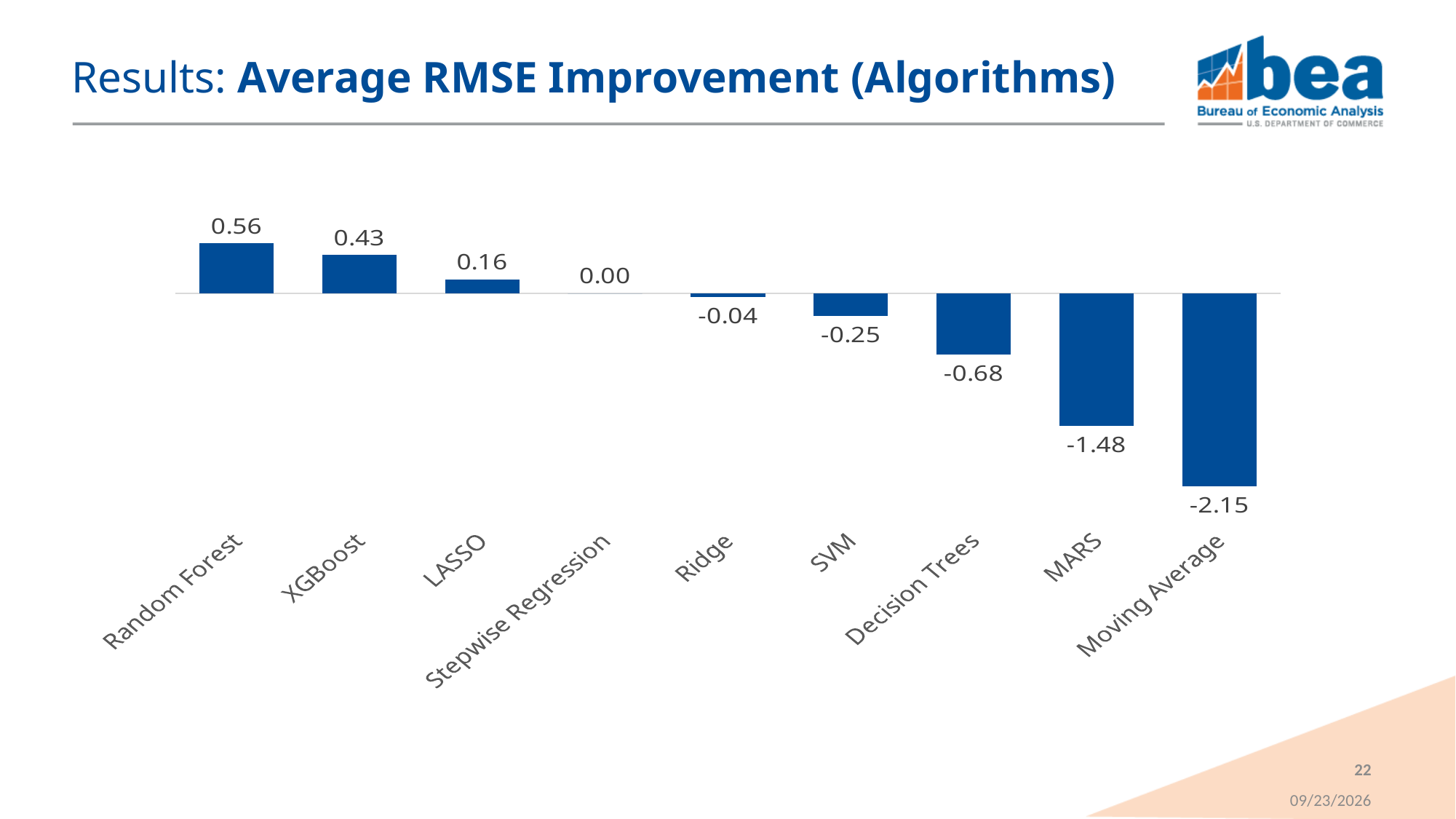
What is the average RMSE improvement for Random Forest? 0.56 What is the average RMSE improvement for Stepwise Regression? 0.00 Which algorithm has the lowest average RMSE improvement? Moving Average What is the average RMSE improvement for Decision Trees? -0.68 What is the difference between the values for Random Forest and XGBoost? 0.13 What is the average RMSE improvement for Moving Average? -2.15 How many algorithms are shown in the chart? 9 What kind of chart is shown on the slide? Bar chart Which algorithm has the highest average RMSE improvement? Random Forest What is the difference between the values for MARS and Moving Average? 0.67 Which has a larger average RMSE improvement, LASSO or SVM? LASSO Do the values rise or fall moving from left to right across the algorithms? Fall